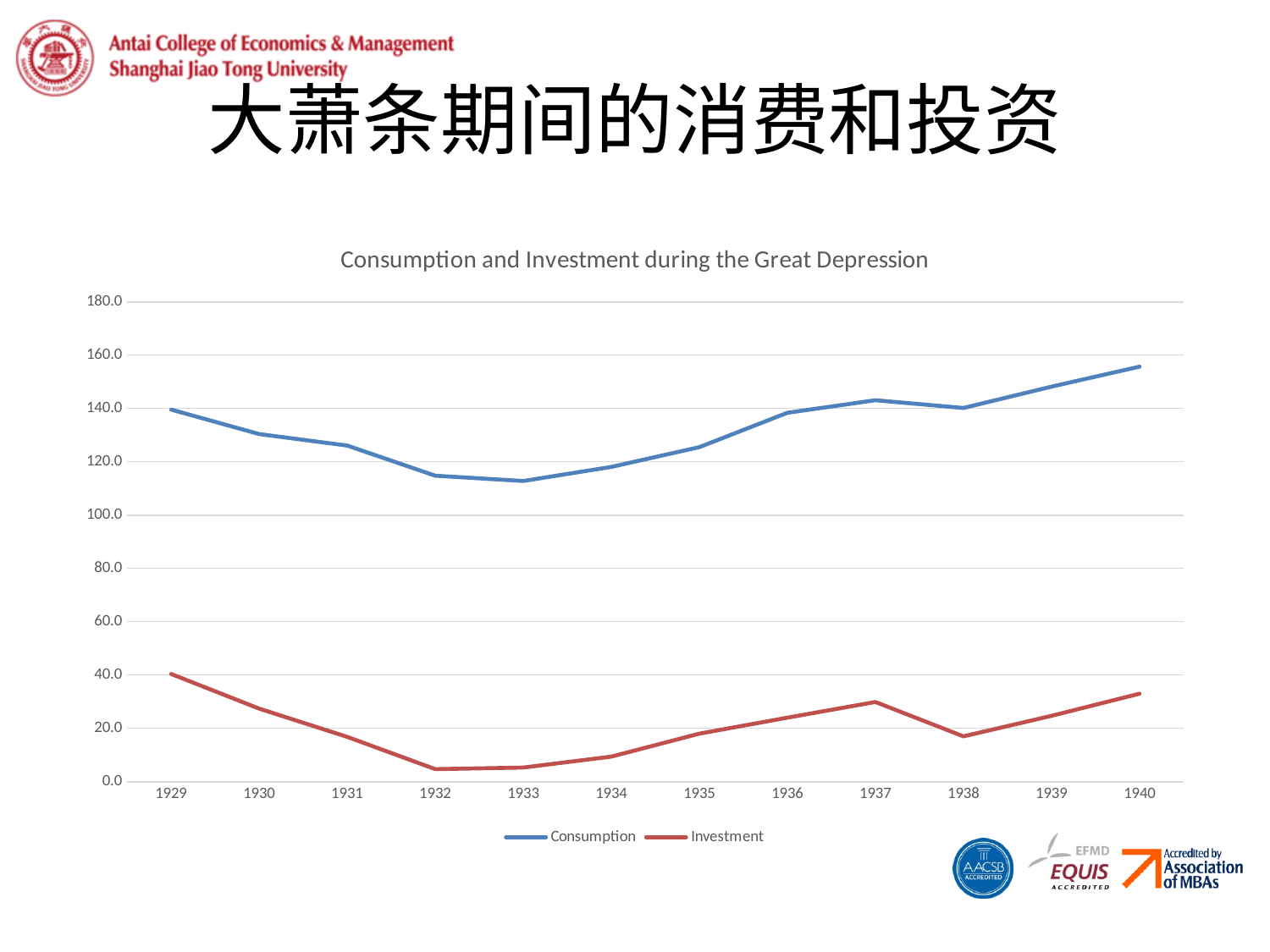
In which year is Consumption highest? 1940 How many years are plotted along the x axis? 12 Is the Investment value for 1932 greater or less than 20? less Is the Investment value for 1937 greater or less than 20? greater Does Consumption rise or fall from 1929 to 1933? fall Which is larger, Investment in 1929 or Investment in 1938? 1929 How many series does the legend list? 2 In which year is Investment highest? 1929 Is the Consumption value for 1933 greater or less than 120? less What kind of chart is shown on the slide? line chart What is the title of the chart? Consumption and Investment during the Great Depression